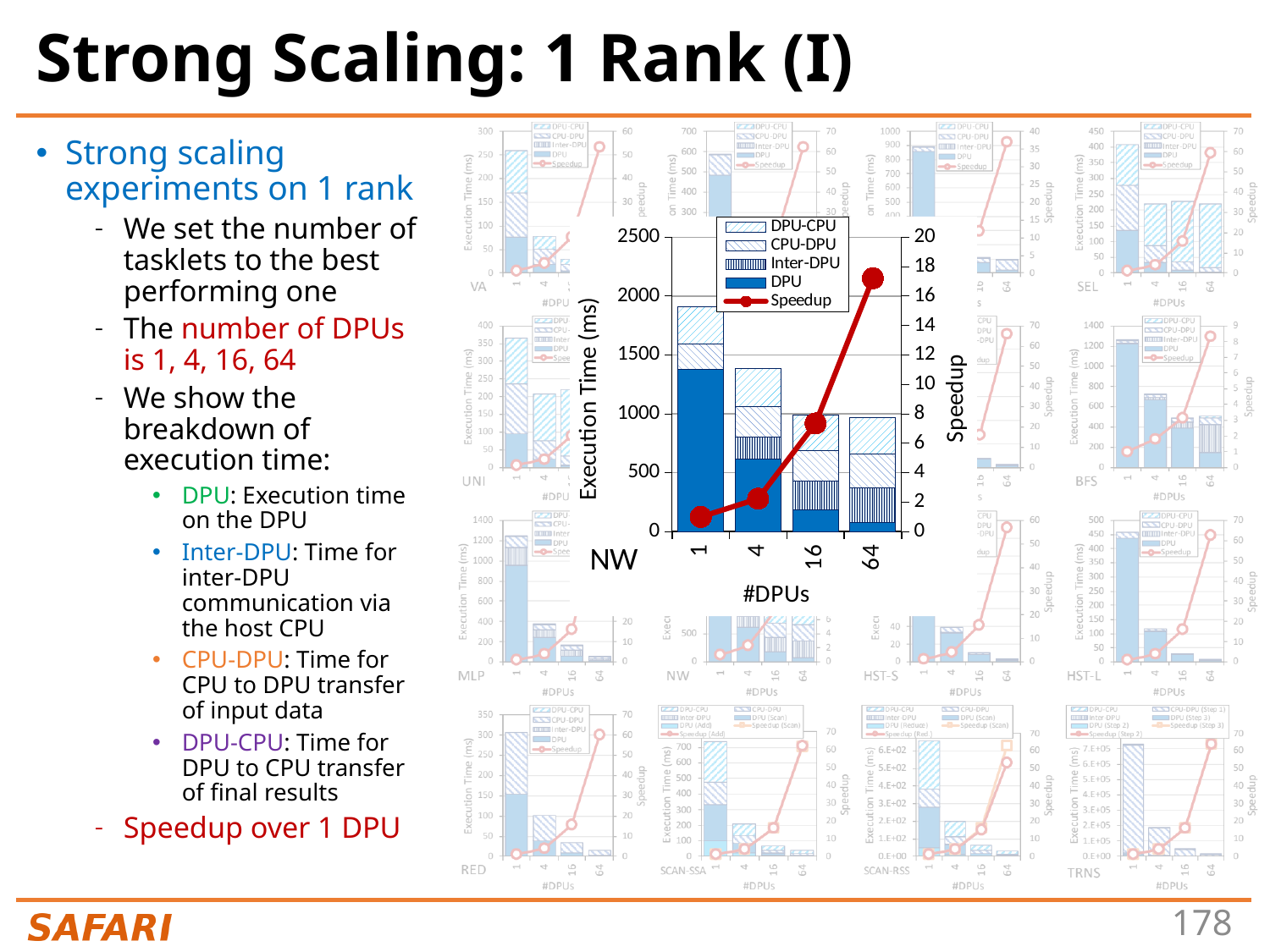
In the highlighted NW chart, how many #DPUs categories are shown on the x axis? 4 In the highlighted NW chart, is the speedup for 16 DPUs greater or less than 10? less In the highlighted NW chart, how many series does the legend list? 5 In the highlighted NW chart, which #DPUs category has the lowest speedup? 1 In the highlighted NW chart, is the speedup for 64 DPUs greater or less than 14? greater What is the x-axis title of the highlighted NW chart? #DPUs In the highlighted NW chart, which #DPUs category has the highest speedup? 64 What kind of chart is the highlighted NW chart? Stacked bar chart with a line In the highlighted NW chart, which has the larger total execution time, 1 DPU or 4 DPUs? 1 DPU In the highlighted NW chart, how does the speedup change as the number of DPUs increases from 1 to 64? It rises In the highlighted NW chart, is the total execution time for 1 DPU greater or less than 1500 ms? greater In the highlighted NW chart, which #DPUs category has the highest total execution time? 1